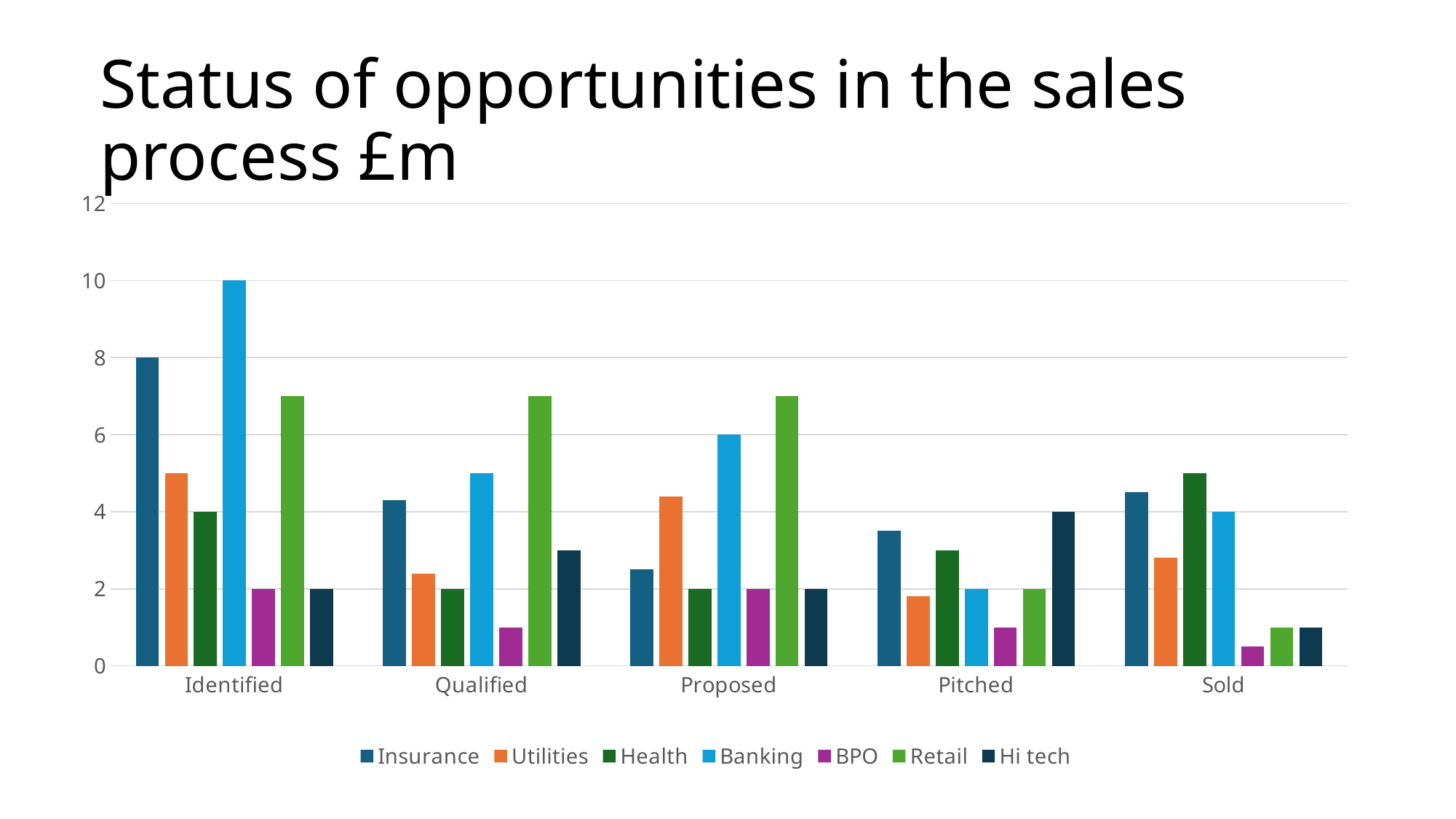
What is the value for Banking at the Identified stage? 10 What is the value for Banking at the Proposed stage? 6 Is the value for Retail at the Qualified stage greater or less than 6? greater Which is larger at the Proposed stage, Utilities or Insurance? Utilities Which series has the lowest value at the Sold stage? BPO Which series has the highest value at the Identified stage? Banking What type of chart is shown on the slide? bar chart How many series does the legend list? 7 What is the value for Insurance at the Identified stage? 8 What is the value for Hi tech at the Pitched stage? 4 What is the difference between Banking and Insurance at the Identified stage? 2 How many sales process stages are shown on the x axis? 5